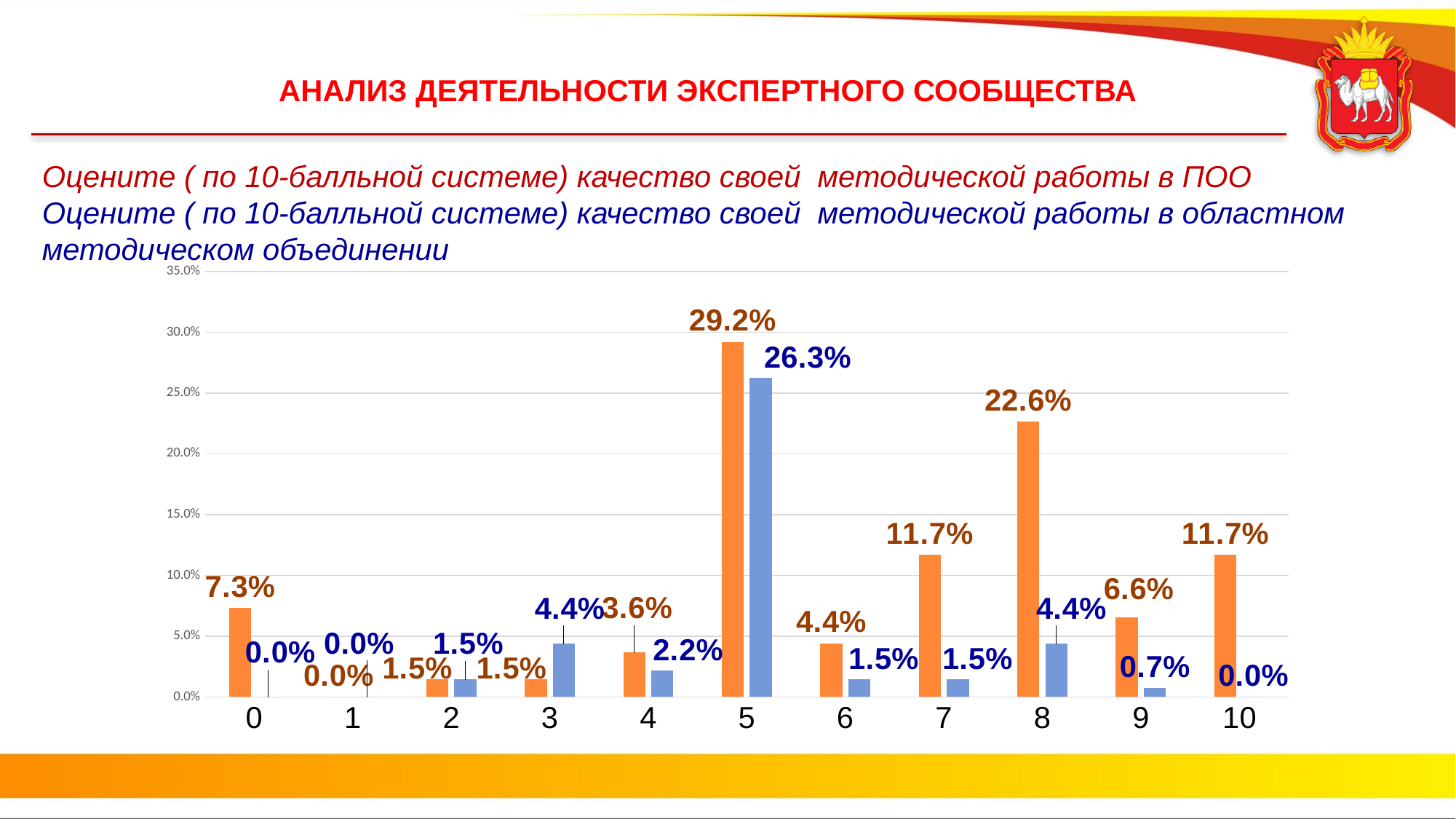
What is the difference between the orange and blue bars for score 5? 2.9% What is the value of the orange bar for score 5? 29.2% How many score categories are shown on the x axis of the chart? 11 What is the value of the blue bar for score 9? 0.7% Which score has the highest blue bar? 5 What is the value of the orange bar for score 8? 22.6% What is the difference between the orange bars for score 8 and score 7? 10.9% What type of chart is shown on the slide? bar chart Which is larger for score 3, the orange bar or the blue bar? the blue bar What is the value of the orange bar for score 0? 7.3% Which score has the highest orange bar? 5 What is the value of the blue bar for score 5? 26.3%